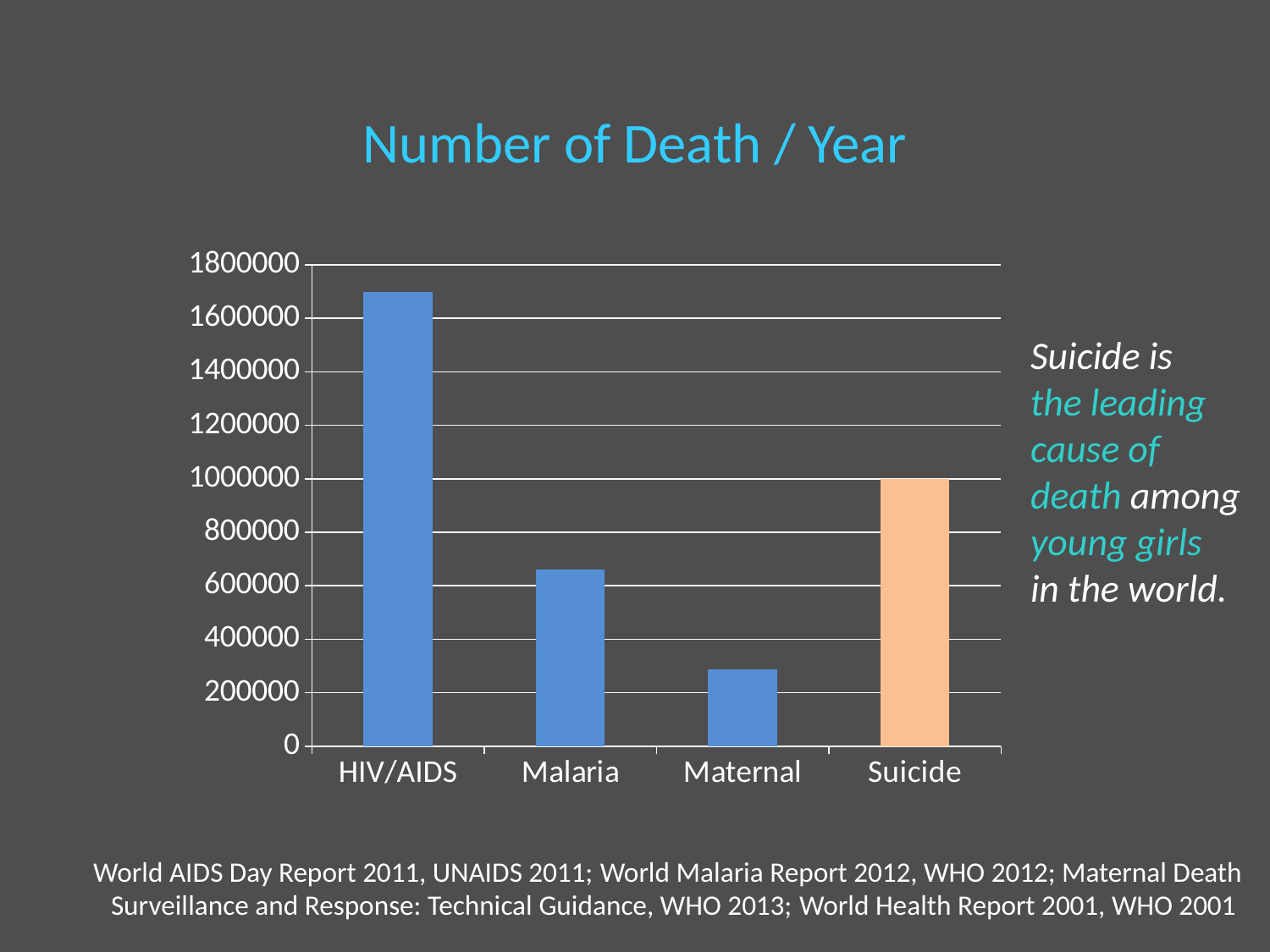
Is the value for Maternal greater or less than 400000? less Which category's bar is shown in a different colour (orange) from the others? Suicide Is the value for Malaria greater or less than 800000? less What kind of chart is shown on the slide? bar chart Which is larger, the value for Malaria or the value for Suicide? Suicide What is the title of the chart? Number of Death / Year Which is larger, the value for HIV/AIDS or the value for Suicide? HIV/AIDS How many categories are plotted on the chart? 4 What is the number of deaths per year for Suicide? 1000000 Which category has the lowest number of deaths per year? Maternal Which category has the highest number of deaths per year? HIV/AIDS Is the value for HIV/AIDS greater or less than 1600000? greater